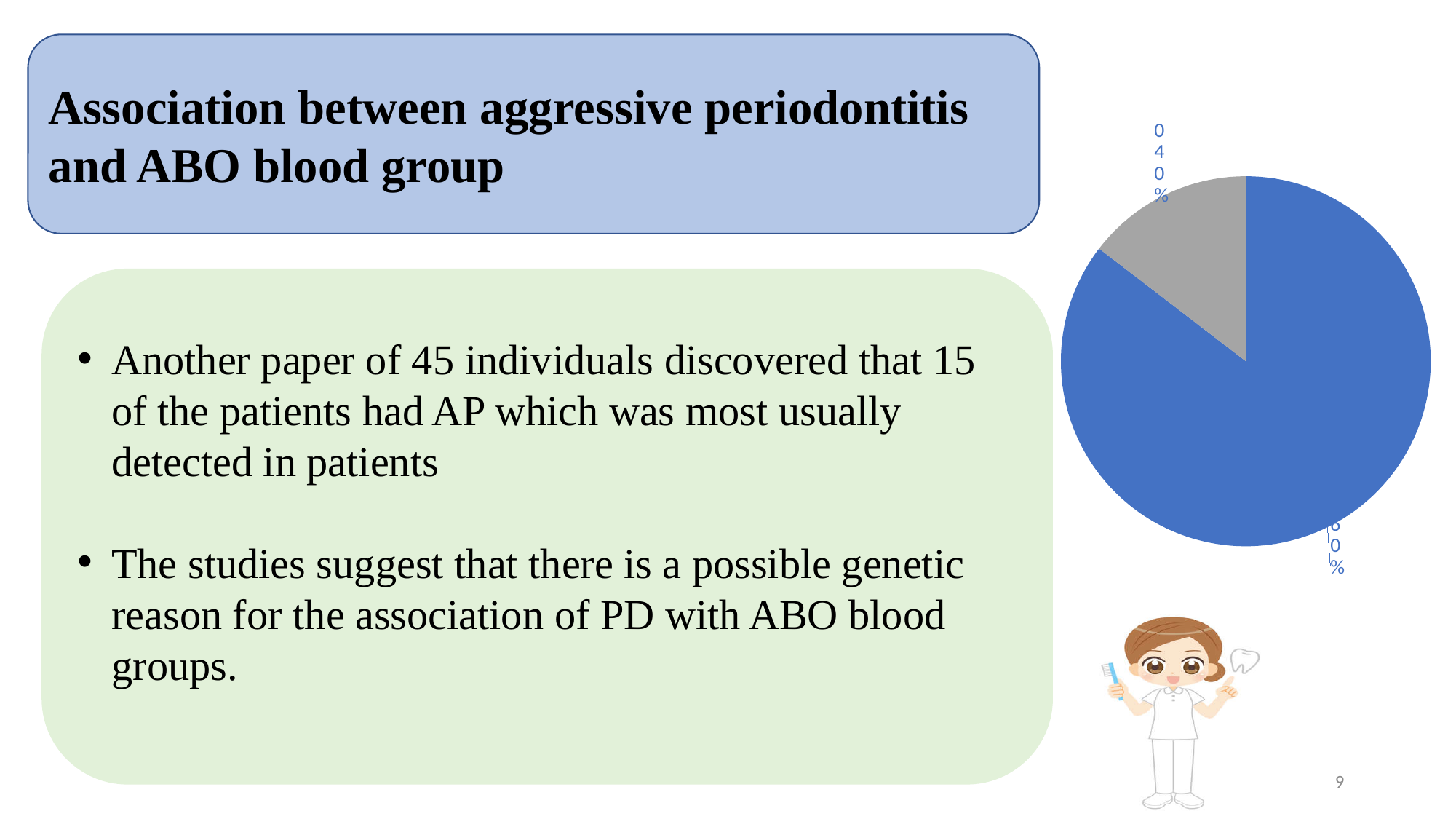
Which slice of the pie chart is the largest? the blue slice How many slices does the pie chart on the slide have? 2 Does the pie chart on the slide have a legend? No What kind of chart is shown on the right side of the slide? pie chart Which slice of the pie chart is larger, the blue one or the gray one? the blue one Which slice of the pie chart is the smallest? the gray slice What colour is the largest slice of the pie chart? blue